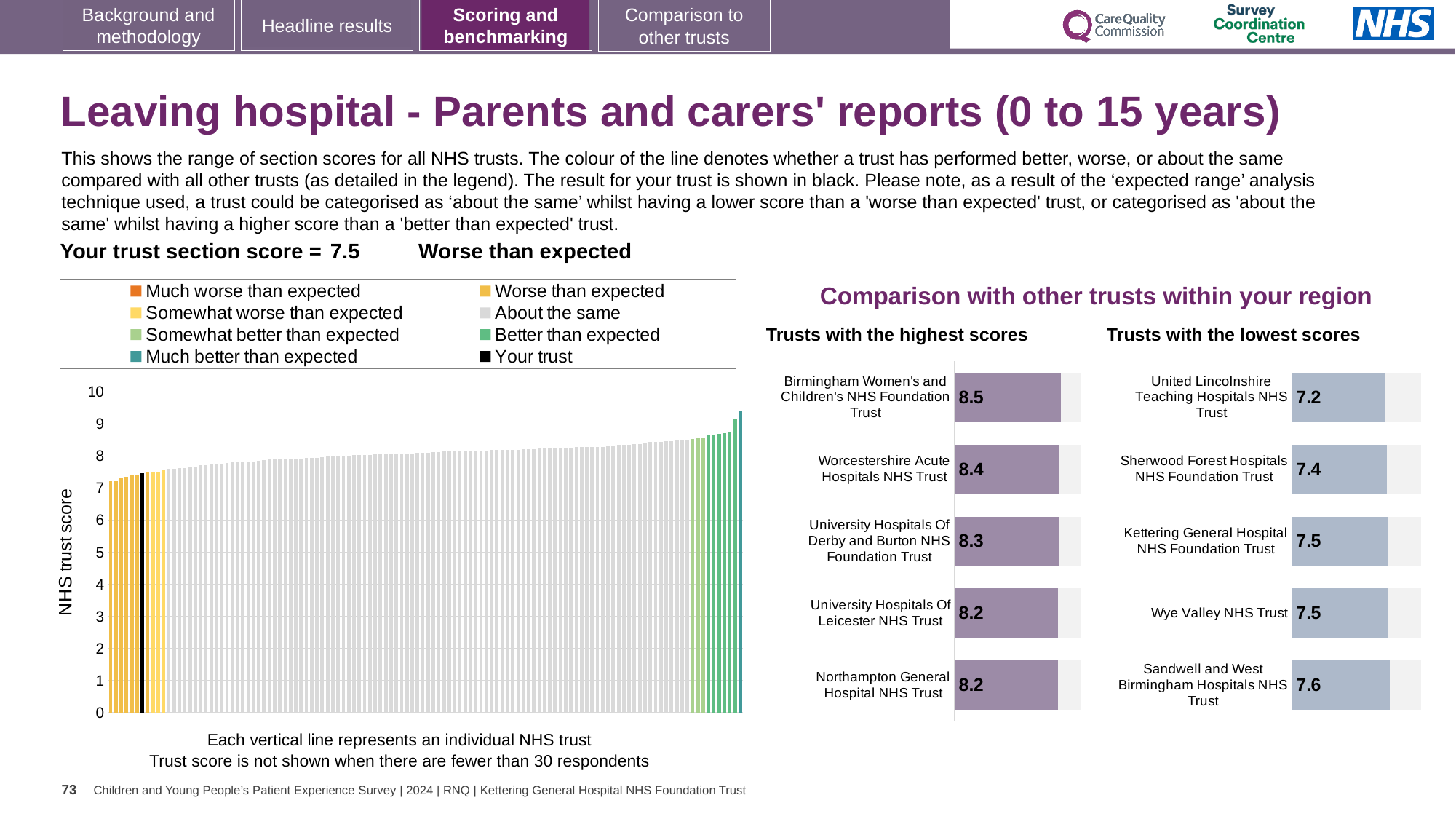
On the 'Trusts with the lowest scores' chart, which has the larger score: Sherwood Forest Hospitals NHS Foundation Trust or Sandwell and West Birmingham Hospitals NHS Trust? Sandwell and West Birmingham Hospitals NHS Trust On the 'Trusts with the lowest scores' chart, what is the score for Sherwood Forest Hospitals NHS Foundation Trust? 7.4 How many trusts are shown on the 'Trusts with the highest scores' chart? 5 What kind of chart is the large chart on the left showing the range of section scores for all NHS trusts? Bar chart On the large chart on the left, do the trust scores rise or fall from left to right? Rise What is the y-axis label of the large chart on the left? NHS trust score On the 'Trusts with the highest scores' chart, what is the difference between the scores of Birmingham Women's and Children's NHS Foundation Trust and Northampton General Hospital NHS Trust? 0.3 How many entries does the legend of the large chart on the left list? 8 On the 'Trusts with the lowest scores' chart, what is the difference between the scores of Sandwell and West Birmingham Hospitals NHS Trust and United Lincolnshire Teaching Hospitals NHS Trust? 0.4 On the 'Trusts with the highest scores' chart, what is the score for Worcestershire Acute Hospitals NHS Trust? 8.4 On the 'Trusts with the highest scores' chart, which trust has the highest score? Birmingham Women's and Children's NHS Foundation Trust On the 'Trusts with the lowest scores' chart, which trust has the lowest score? United Lincolnshire Teaching Hospitals NHS Trust